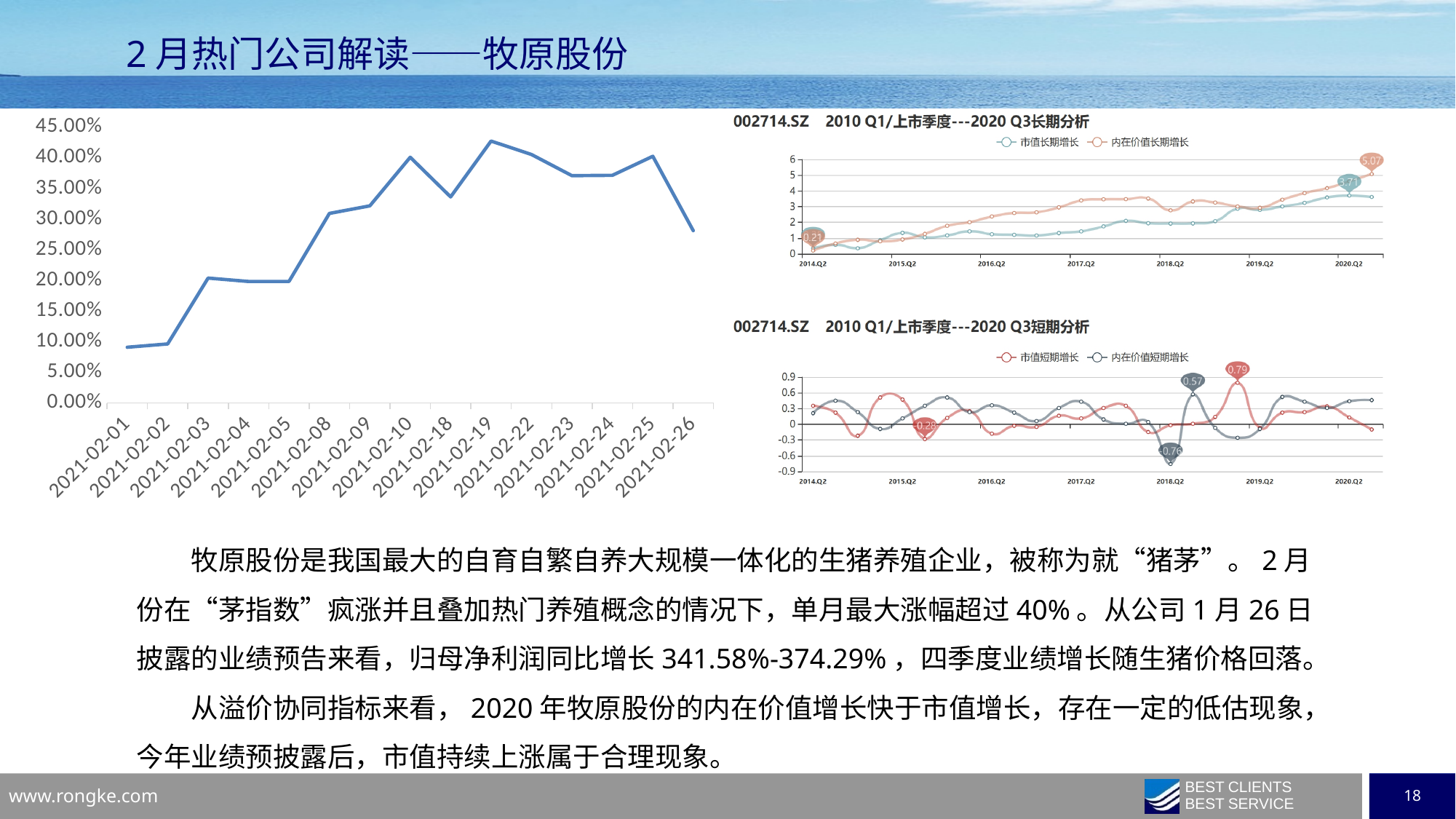
In the chart on the left, is the value for 2021-02-26 greater or less than 25.00%? greater In the chart on the left, which is larger, the value for 2021-02-08 or the value for 2021-02-05? 2021-02-08 In the chart on the left, is the value for 2021-02-03 greater or less than 25.00%? less What kind of chart is the chart on the left of the slide? line chart In the chart on the left, which date has the highest value? 2021-02-19 In the chart titled '002714.SZ 2010 Q1/上市季度---2020 Q3短期分析', what is the highest labelled value of 市值短期增长? 0.79 In the chart titled '002714.SZ 2010 Q1/上市季度---2020 Q3长期分析', what is the labelled value of 市值长期增长 near 2020.Q2? 3.71 In the chart titled '002714.SZ 2010 Q1/上市季度---2020 Q3长期分析', how many series does the legend list? 2 In the chart titled '002714.SZ 2010 Q1/上市季度---2020 Q3短期分析', what is the lowest labelled value of 内在价值短期增长? -0.76 In the chart on the left, is the value for 2021-02-10 greater or less than 35.00%? greater In the chart on the left, how many dates are plotted along the x axis? 15 In the chart titled '002714.SZ 2010 Q1/上市季度---2020 Q3长期分析', what is the final labelled value of 内在价值长期增长? 5.07